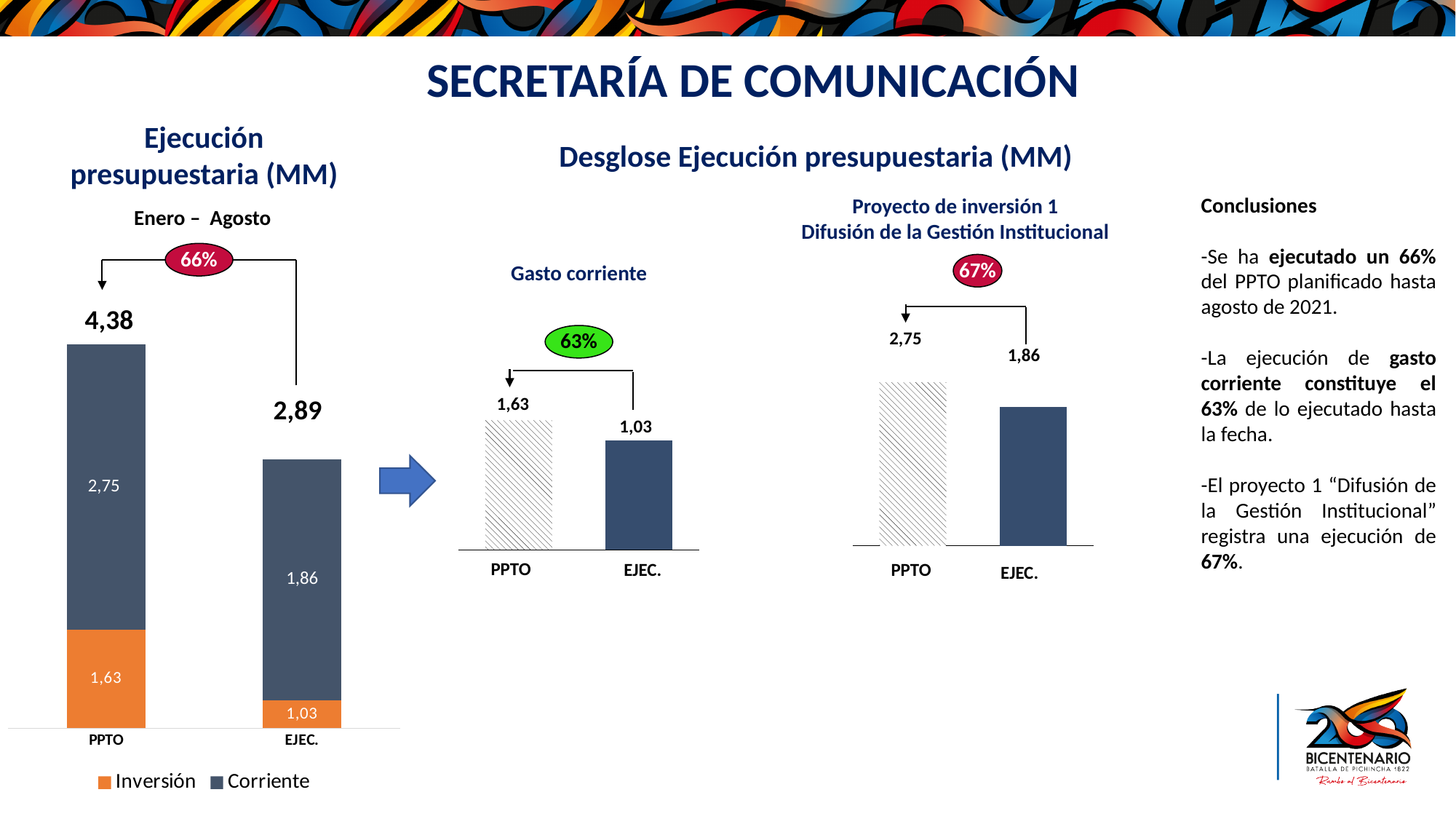
How many series does the legend of the 'Ejecución presupuestaria (MM)' chart list? 2 In the 'Ejecución presupuestaria (MM)' chart, what is the total of the PPTO stacked bar? 4,38 In the 'Ejecución presupuestaria (MM)' chart, what is the Inversión value for EJEC.? 1,03 In the 'Ejecución presupuestaria (MM)' chart, what is the difference between the Corriente values for PPTO and EJEC.? 0,89 In the 'Ejecución presupuestaria (MM)' chart, which colour represents the Inversión series? Orange What kind of chart is the 'Ejecución presupuestaria (MM)' chart? Stacked bar chart In the 'Proyecto de inversión 1 Difusión de la Gestión Institucional' chart, what is the difference between PPTO and EJEC.? 0,89 In the 'Gasto corriente' chart, which category has the higher value, PPTO or EJEC.? PPTO In the 'Proyecto de inversión 1 Difusión de la Gestión Institucional' chart, what is the value for PPTO? 2,75 In the 'Ejecución presupuestaria (MM)' chart, what is the Corriente value for PPTO? 2,75 In the 'Gasto corriente' chart, what is the value for EJEC.? 1,03 In the 'Ejecución presupuestaria (MM)' chart, what is the total of the EJEC. stacked bar? 2,89